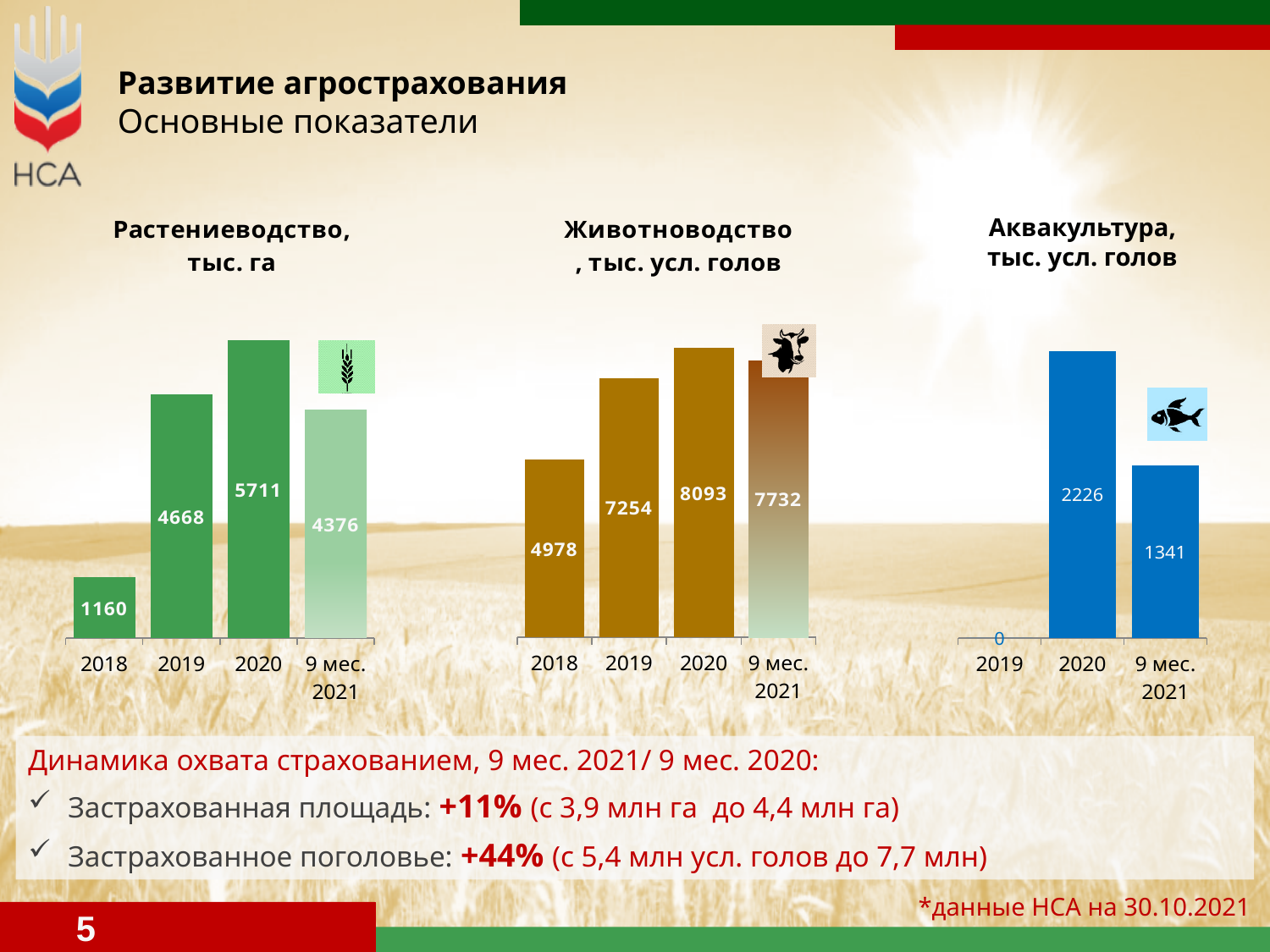
In the "Животноводство, тыс. усл. голов" chart, which is larger: the value for 2020 or the value for 9 мес. 2021? 2020 In the "Аквакультура, тыс. усл. голов" chart, what is the difference between the 2020 value and the 9 мес. 2021 value? 885 What type of chart is the "Растениеводство, тыс. га" chart? Bar chart In the "Животноводство, тыс. усл. голов" chart, which period has the highest value? 2020 In the "Растениеводство, тыс. га" chart, how many bars are plotted? 4 In the "Аквакультура, тыс. усл. голов" chart, what is the value for 9 мес. 2021? 1341 In the "Растениеводство, тыс. га" chart, what is the difference between the 2020 value and the 9 мес. 2021 value? 1335 In the "Растениеводство, тыс. га" chart, what is the value for 2020? 5711 In the "Растениеводство, тыс. га" chart, which year has the lowest value? 2018 In the "Животноводство, тыс. усл. голов" chart, what is the value for 2018? 4978 In the "Аквакультура, тыс. усл. голов" chart, what is the value for 2020? 2226 In the "Животноводство, тыс. усл. голов" chart, what is the difference between the 2019 and 2018 values? 2276